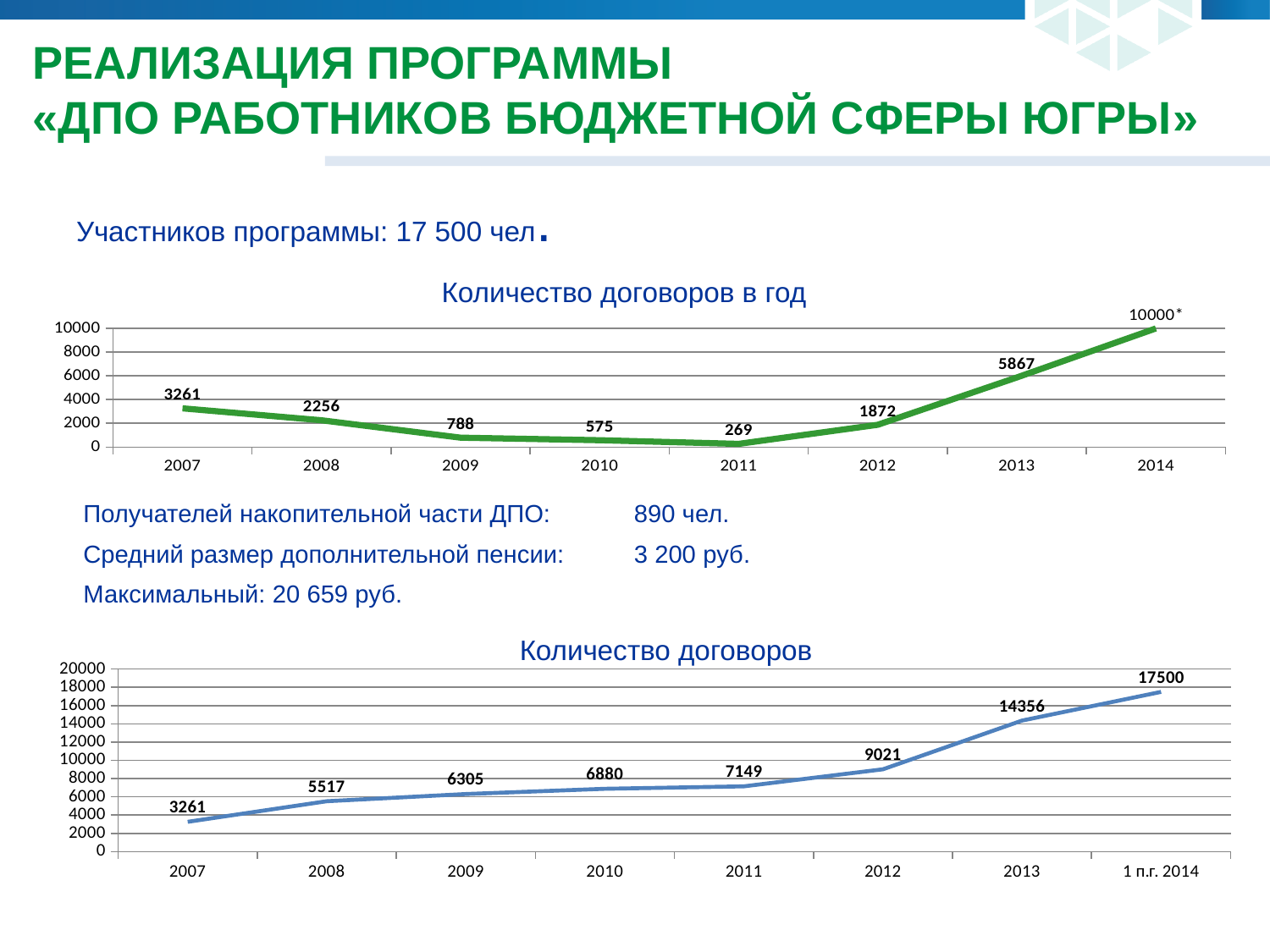
In the chart titled "Количество договоров", do the values rise or fall from 2007 to 1 п.г. 2014? rise In the chart titled "Количество договоров в год", which is larger, the value for 2007 or the value for 2008? 2007 In the chart titled "Количество договоров", what is the difference between the values for 2013 and 2012? 5335 What kind of chart is the chart titled "Количество договоров"? line chart In the chart titled "Количество договоров в год", what is the difference between the values for 2013 and 2012? 3995 In the chart titled "Количество договоров", is the value for 2011 greater or less than 8000? less In the chart titled "Количество договоров в год", what is the value for 2009? 788 In the chart titled "Количество договоров в год", how many years are plotted? 8 In the chart titled "Количество договоров в год", what is the value for 2014? 10000* In the chart titled "Количество договоров в год", which year has the lowest value? 2011 In the chart titled "Количество договоров", what is the value for 2012? 9021 In the chart titled "Количество договоров", which category has the highest value? 1 п.г. 2014